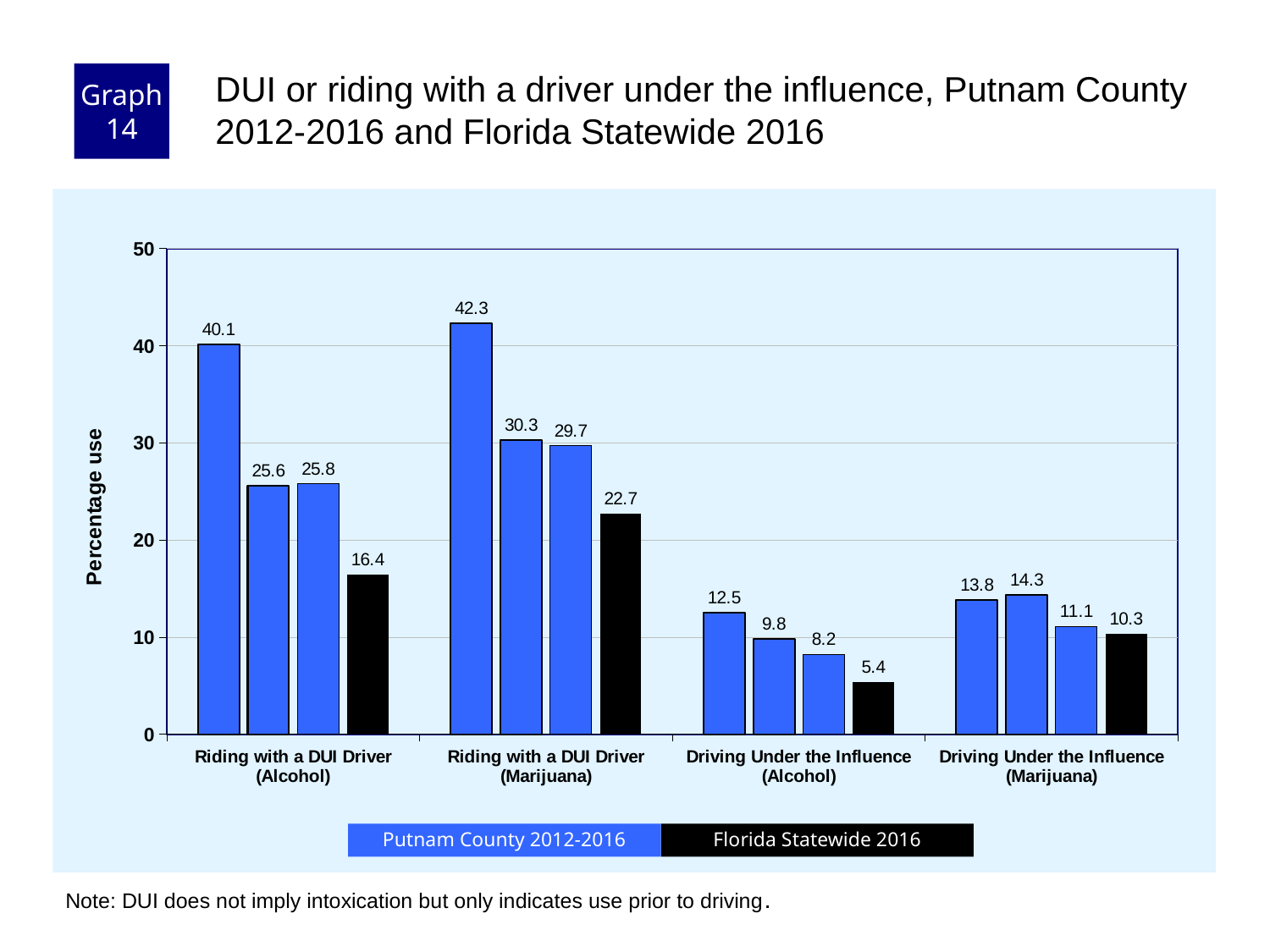
What is the difference between the Florida Statewide 2016 values for Riding with a DUI Driver (Marijuana) and Riding with a DUI Driver (Alcohol)? 6.3 What is the Florida Statewide 2016 value for Riding with a DUI Driver (Alcohol)? 16.4 How many series does the legend list? 2 How many categories are shown on the x axis? 4 What is the lowest value shown on the chart? 5.4 What is the Florida Statewide 2016 value for Riding with a DUI Driver (Marijuana)? 22.7 What kind of chart is shown? Bar chart Which is larger: the Florida Statewide 2016 value for Driving Under the Influence (Marijuana) or for Driving Under the Influence (Alcohol)? Driving Under the Influence (Marijuana) What is the label of the y axis? Percentage use Which category has the highest Florida Statewide 2016 value? Riding with a DUI Driver (Marijuana) What is the highest value shown on the chart? 42.3 What is the Florida Statewide 2016 value for Driving Under the Influence (Alcohol)? 5.4